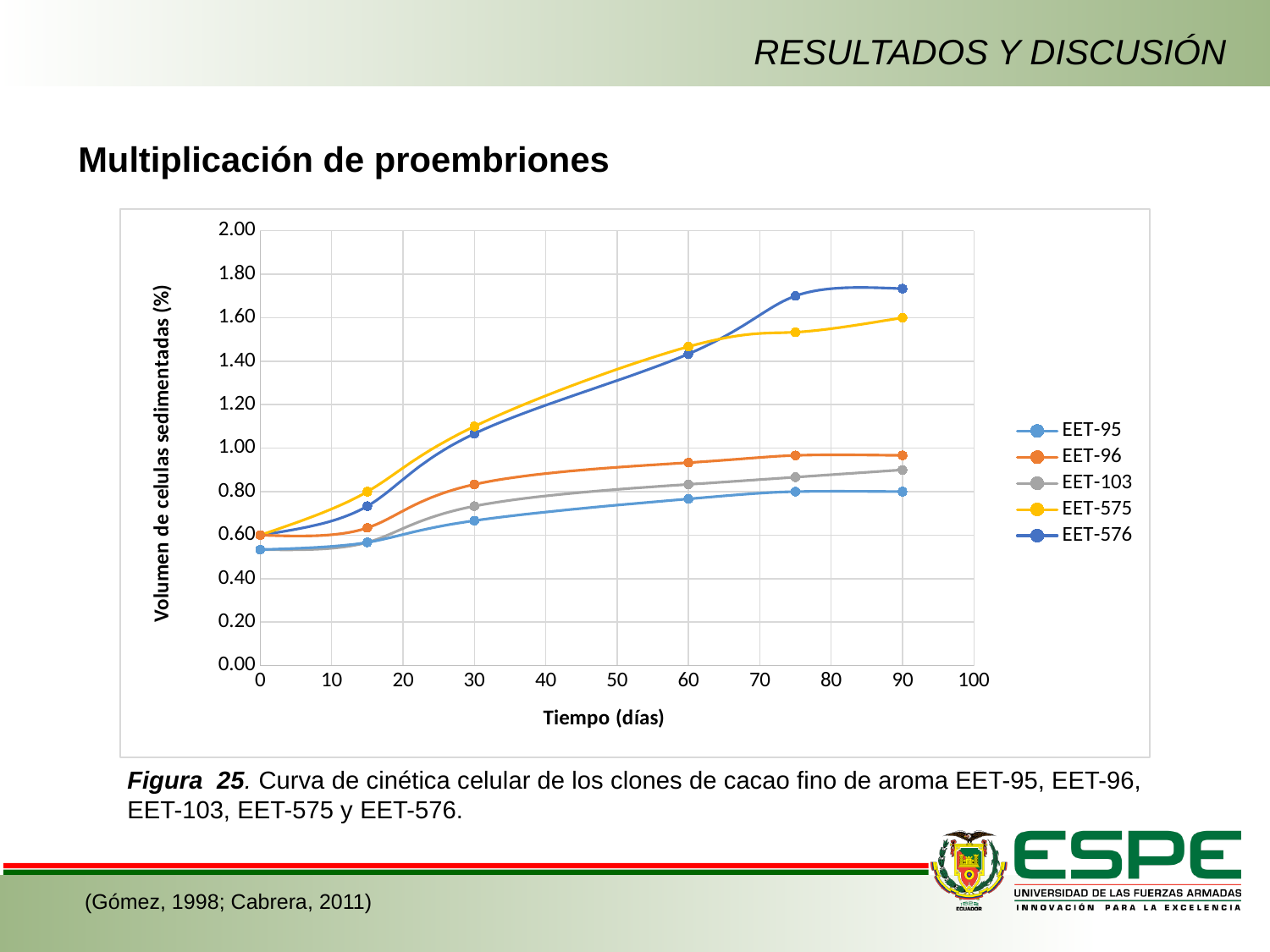
Which series has the lowest value at day 90? EET-95 What is the title of the x axis? Tiempo (días) Do the values for EET-575 rise or fall as time increases? rise At day 75, which series has the larger value, EET-576 or EET-575? EET-576 Is the value for EET-575 at day 60 greater or less than 1.40? greater What kind of chart is shown on the slide? line chart At day 30, which series has the larger value, EET-96 or EET-103? EET-96 Which series has the highest value at day 90? EET-576 Is the value for EET-576 at day 90 greater or less than 1.60? greater How many series does the legend list? 5 How many time points are plotted for each series? 6 Is the value for EET-95 at day 90 greater or less than 1.00? less